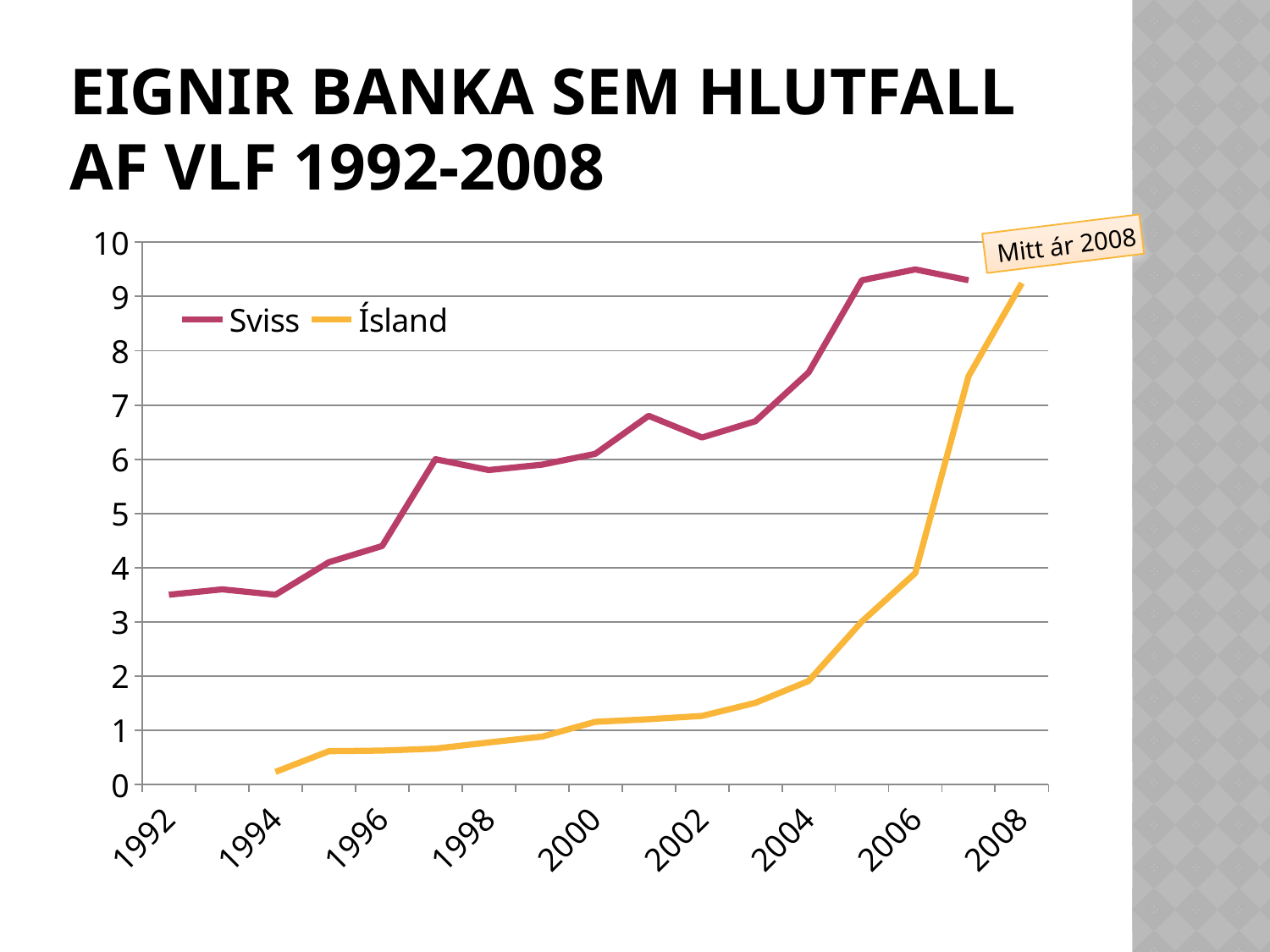
Is the value for Sviss in 2006 greater or less than 9? greater Is the value for Ísland in 2004 greater or less than 3? less Which two series are shown in the legend? Sviss and Ísland Is the value for Ísland in 2000 greater or less than 2? less What kind of chart is shown on the slide? line chart How many series does the legend list? 2 What is the title of the chart on the slide? EIGNIR BANKA SEM HLUTFALL AF VLF 1992-2008 In which year does the Ísland series reach its highest value? 2008 Does the Ísland series generally rise or fall from 1994 to 2008? rise In 2000, which series has the larger value, Sviss or Ísland? Sviss